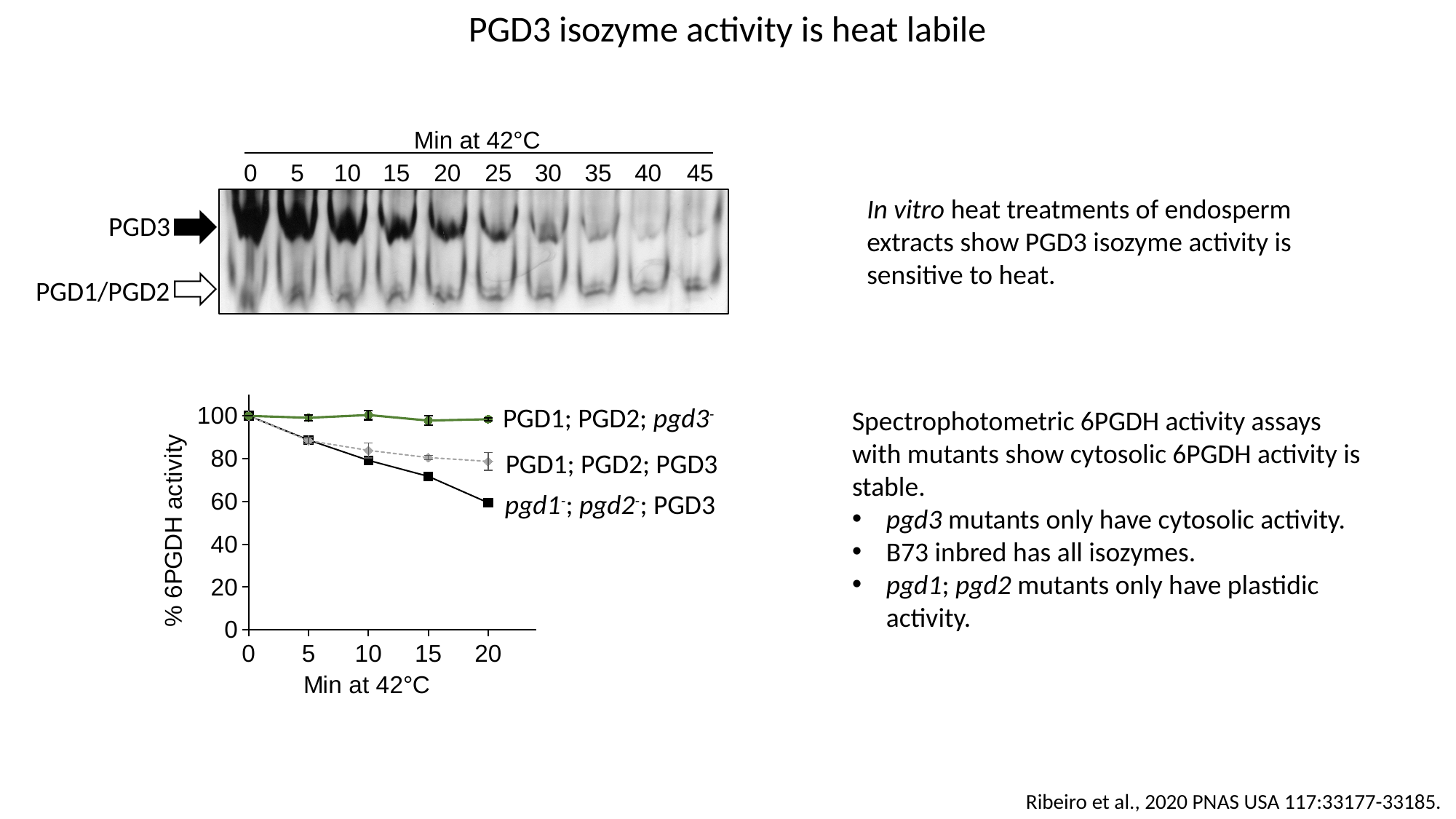
Is the % 6PGDH activity for pgd1-; pgd2-; PGD3 at 20 min greater or less than 80? less What kind of chart is shown on the slide? line chart Which series has the highest % 6PGDH activity at 20 min at 42°C? PGD1; PGD2; pgd3- How many series are plotted in the line chart? 3 Does the % 6PGDH activity for the pgd1-; pgd2-; PGD3 series rise or fall as minutes at 42°C increase? fall Is the % 6PGDH activity for PGD1; PGD2; pgd3- at 20 min greater or less than 80? greater At 20 min at 42°C, which series has the larger % 6PGDH activity: PGD1; PGD2; PGD3 or pgd1-; pgd2-; PGD3? PGD1; PGD2; PGD3 Which series has the lowest % 6PGDH activity at 20 min at 42°C? pgd1-; pgd2-; PGD3 What is the label of the x axis of the line chart? Min at 42°C Is the % 6PGDH activity for PGD1; PGD2; PGD3 at 20 min greater or less than 60? greater How many time points are plotted along the x axis of the line chart? 5 What is the label of the y axis of the line chart? % 6PGDH activity